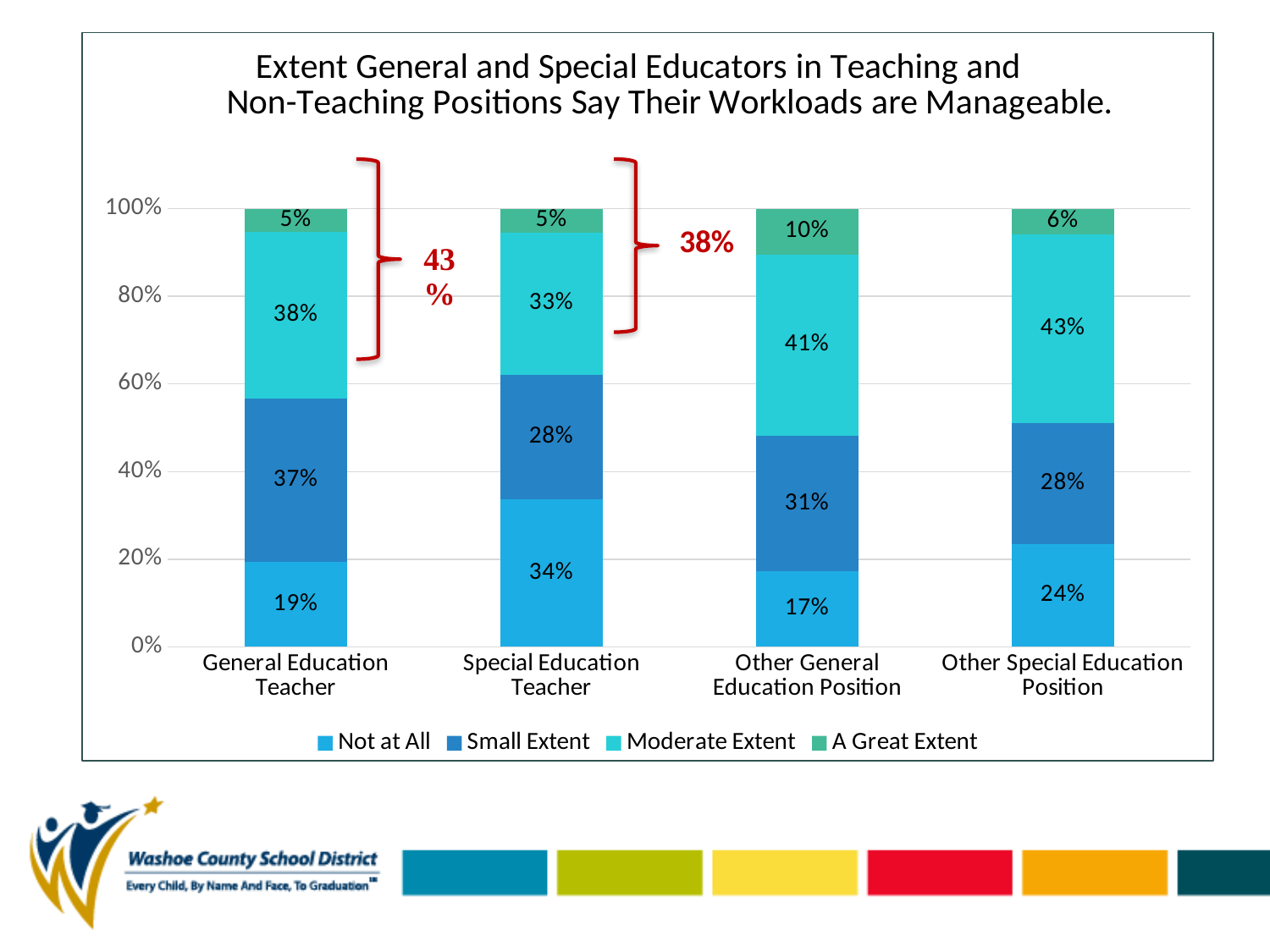
How many series does the legend list? 4 What is the 'A Great Extent' value for Other General Education Position? 10% Which category has the highest 'A Great Extent' value? Other General Education Position Which category has the lowest 'Not at All' value? Other General Education Position How many position categories are shown on the x axis? 4 What kind of chart is shown on the slide? Stacked bar chart What is the 'Small Extent' value for General Education Teacher? 37% What is the 'Moderate Extent' value for Other Special Education Position? 43% What is the 'Not at All' value for Special Education Teacher? 34% Which is larger: the 'Moderate Extent' value for General Education Teacher or for Special Education Teacher? General Education Teacher What is the combined 'Moderate Extent' and 'A Great Extent' share for General Education Teacher, as annotated on the slide? 43% What is the difference between the 'Not at All' values for Special Education Teacher and General Education Teacher? 15%